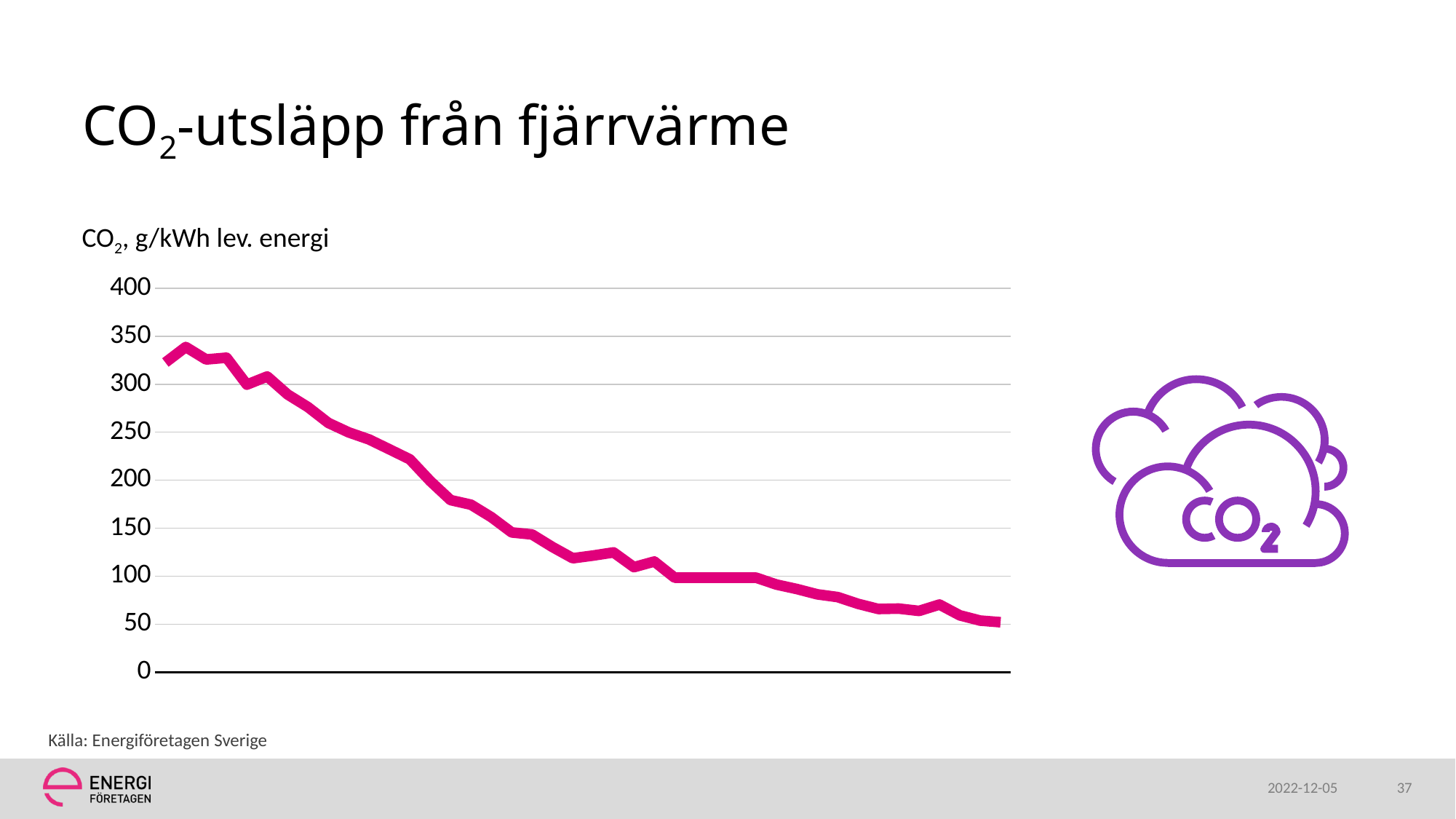
What is the highest value shown on the vertical axis? 400 Is the value at the end (rightmost point) of the line greater or less than 100? less What kind of chart is shown on the slide? line chart Which end of the line is higher, the left end or the right end? the left end Is the value at the start (leftmost point) of the line greater or less than 300? greater Do the values in the chart generally rise or fall from left to right? fall Is the lowest point of the line greater or less than 100? less What unit label is shown above the chart's vertical axis? CO2, g/kWh lev. energi